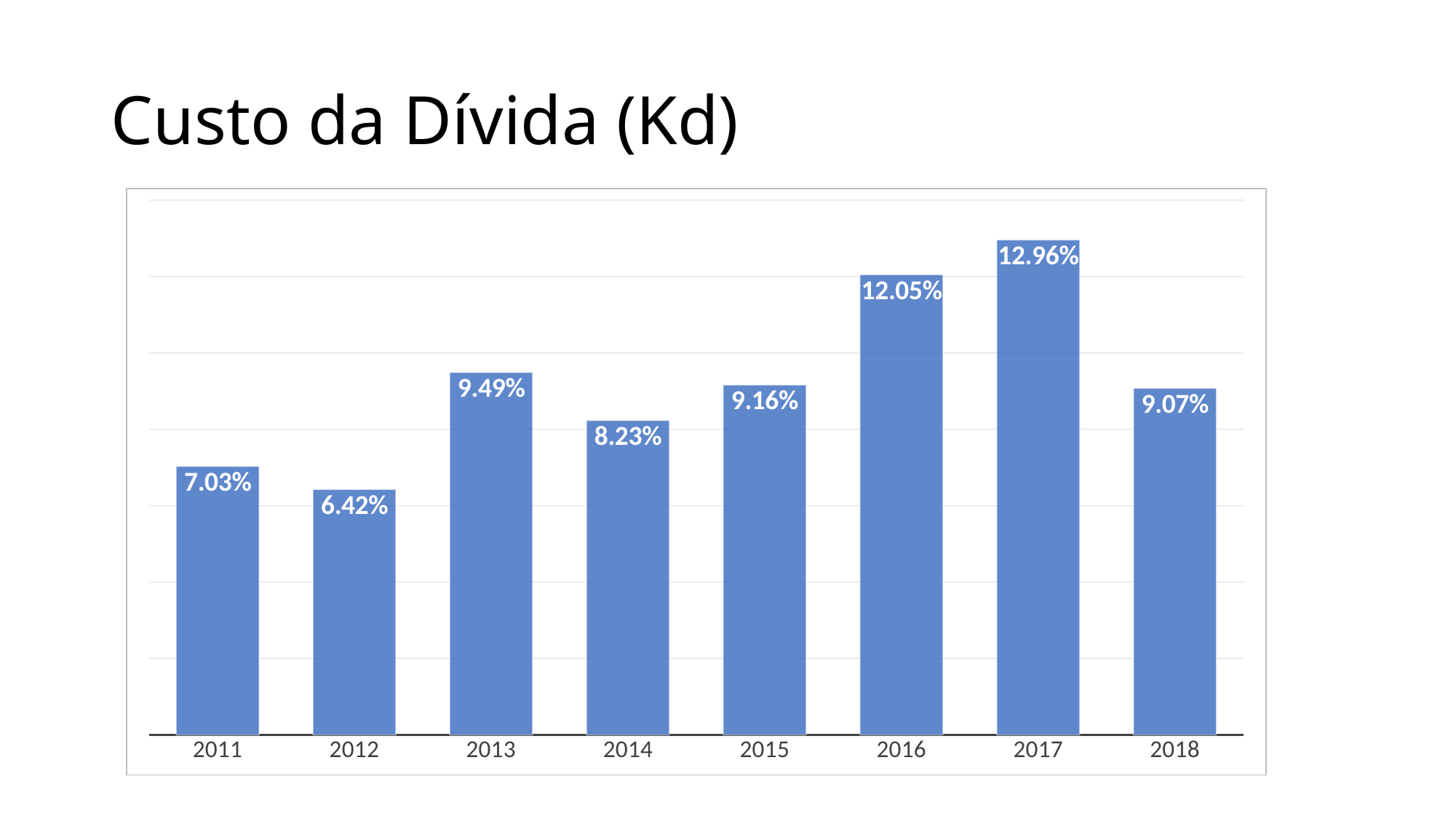
What is the value for 2011? 7.03% What is the value for 2016? 12.05% Which year has the lowest value? 2012 What is the value for 2018? 9.07% What is the title of the slide? Custo da Dívida (Kd) Which year has the highest value? 2017 Which is larger, the value for 2011 or the value for 2018? 2018 What is the difference between the values for 2017 and 2016? 0.91% What is the difference between the values for 2013 and 2012? 3.07% How many years are shown on the x axis? 8 What kind of chart is shown on the slide? Bar chart Which is larger, the value for 2015 or the value for 2014? 2015